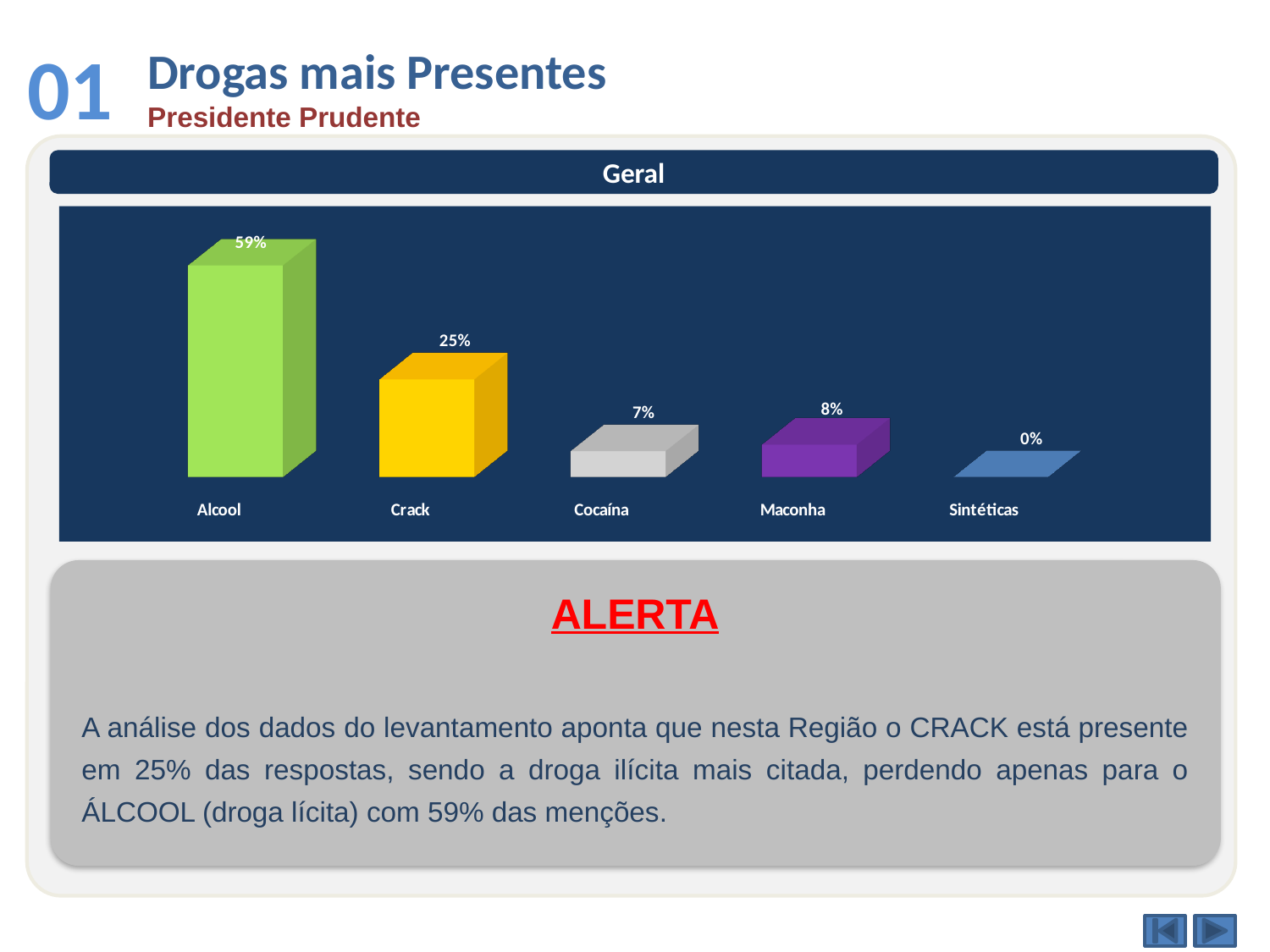
Which category has the lowest value? Sintéticas What is the value for Cocaína? 7% What is the value for Maconha? 8% What kind of chart is shown on the slide? Bar chart What is the value for Crack? 25% Which is larger, the value for Crack or the value for Maconha? Crack What is the value for Alcool? 59% How many categories are shown in the chart? 5 What is the difference between the values for Alcool and Crack? 34% What is the title shown above the chart? Geral Which category has the highest value? Alcool What is the value for Sintéticas? 0%